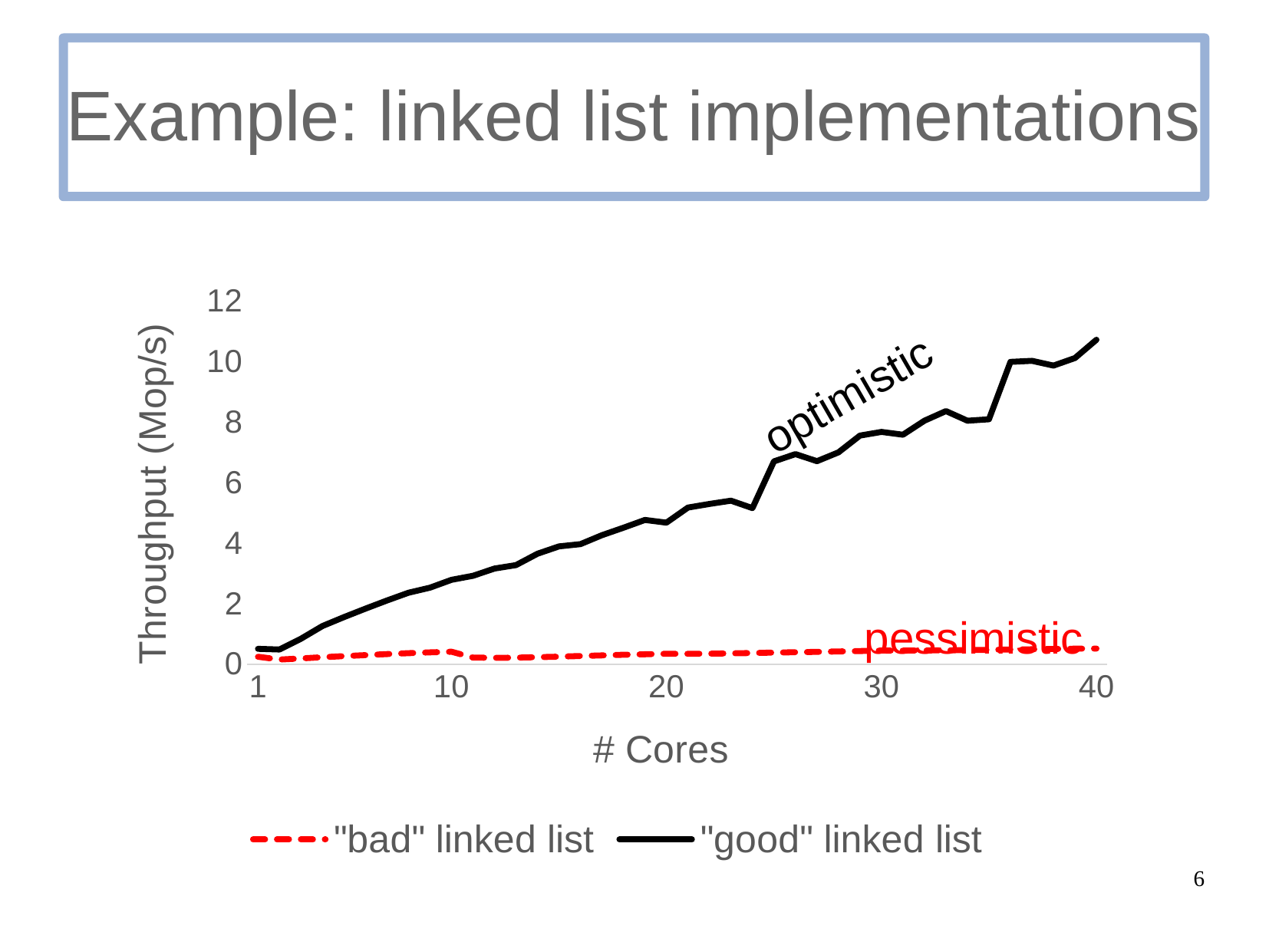
Is the throughput of the "bad" linked list at 40 cores greater or less than 2? less Does the throughput of the "good" linked list rise or fall as the number of cores increases? rise Which series reaches the highest throughput on the chart? "good" linked list How many series does the legend list? 2 Which series is drawn as a red dashed line? "bad" linked list Is the throughput of the "good" linked list at 20 cores greater or less than 6? less Is the throughput of the "good" linked list at 40 cores greater or less than 10? greater Which series has the lowest throughput across the chart? "bad" linked list At 30 cores, which series has the higher throughput, the "bad" linked list or the "good" linked list? "good" linked list What kind of chart is shown on the slide? line chart What is the label of the y axis? Throughput (Mop/s)